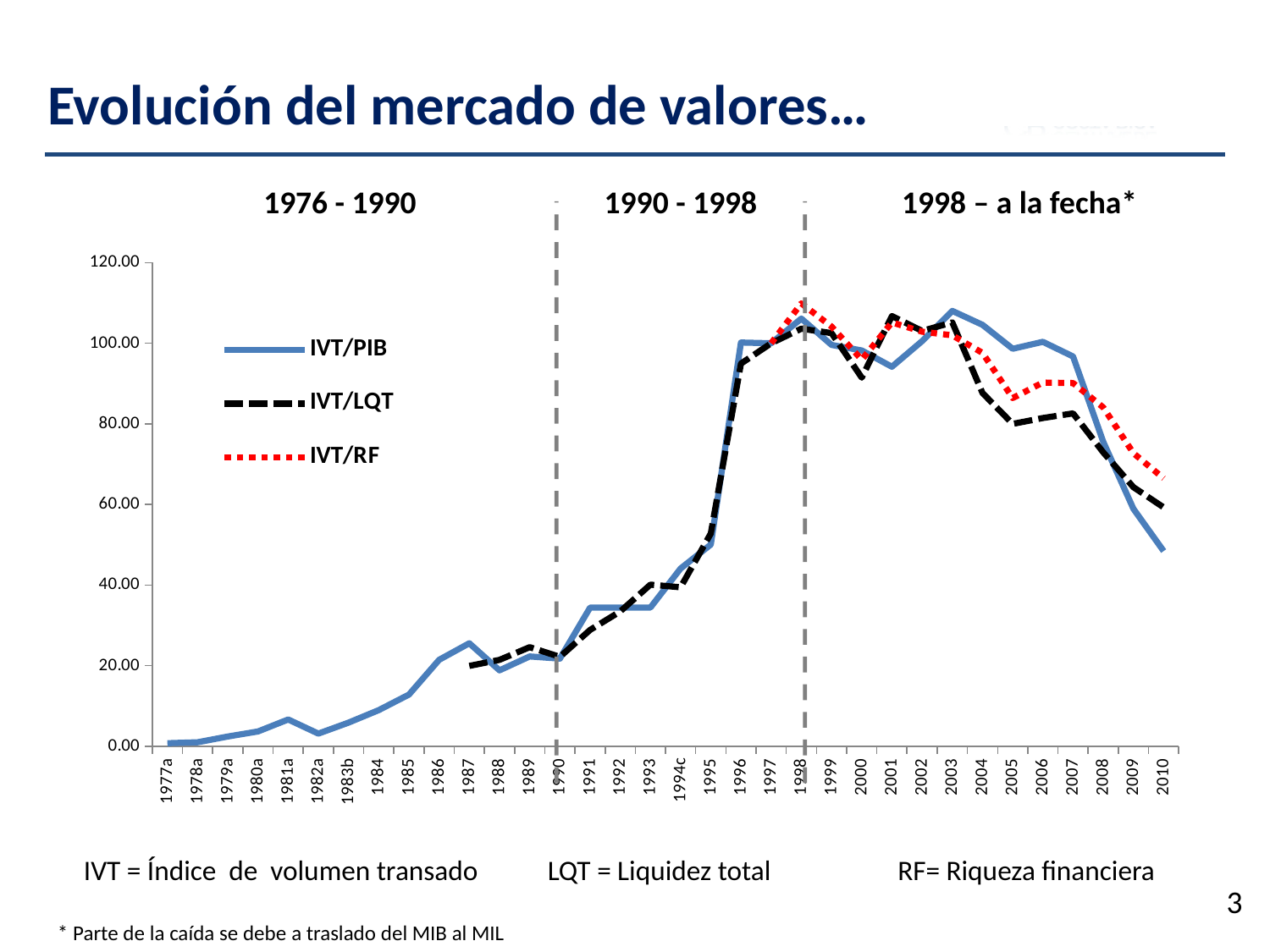
Does the IVT/PIB series rise or fall between 2003 and 2010? fall Is the value of IVT/PIB in 1985 greater or less than 20? less In 2005, which series has the higher value, IVT/PIB or IVT/LQT? IVT/PIB What kind of chart is shown on the slide? line chart Is the value of IVT/PIB in 2010 greater or less than 60? less Is the value of IVT/RF in 2010 greater or less than 60? greater In 2010, which series has the higher value, IVT/RF or IVT/PIB? IVT/RF What are the three series named in the chart legend? IVT/PIB, IVT/LQT, IVT/RF Which series is drawn as a red dotted line? IVT/RF How many series does the chart legend list? 3